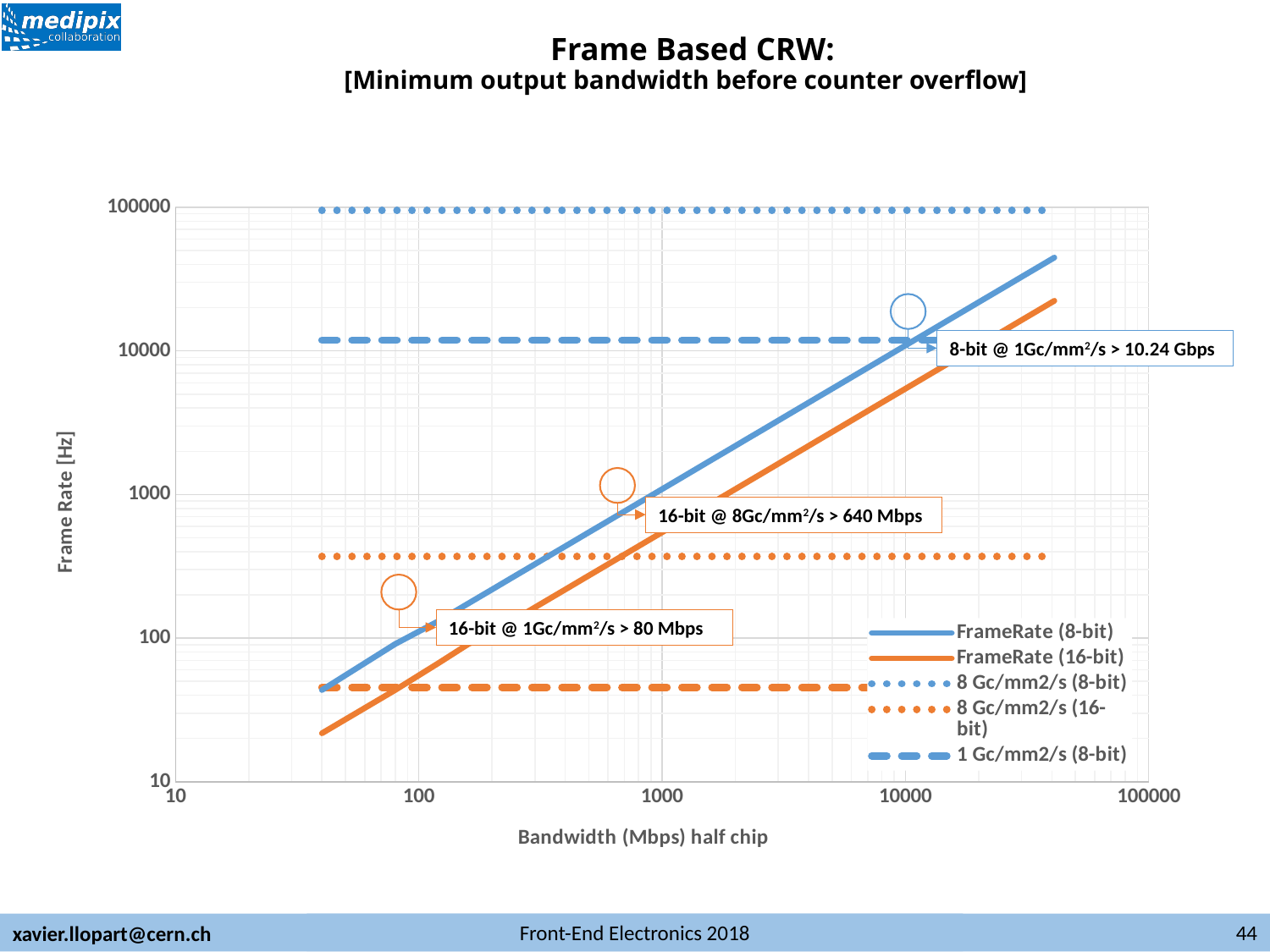
Is the frame rate of the 8 Gc/mm2/s (8-bit) line greater or less than 10000 Hz? greater According to the annotation, what minimum bandwidth is needed for 8-bit at 1Gc/mm²/s? > 10.24 Gbps What is the title of the y axis? Frame Rate [Hz] According to the annotation, what minimum bandwidth is needed for 16-bit at 8Gc/mm²/s? > 640 Mbps At the same bandwidth, which line is higher: FrameRate (8-bit) or FrameRate (16-bit)? FrameRate (8-bit) Does the FrameRate (8-bit) line rise or fall as bandwidth increases? rise How many series does the chart legend list? 5 According to the annotation, what minimum bandwidth is needed for 16-bit at 1Gc/mm²/s? > 80 Mbps What kind of chart is shown on the slide? line chart Is the frame rate of the 8 Gc/mm2/s (16-bit) line greater or less than 1000 Hz? less Which horizontal line is higher: 8 Gc/mm2/s (8-bit) or 8 Gc/mm2/s (16-bit)? 8 Gc/mm2/s (8-bit) What is the title of the x axis? Bandwidth (Mbps) half chip